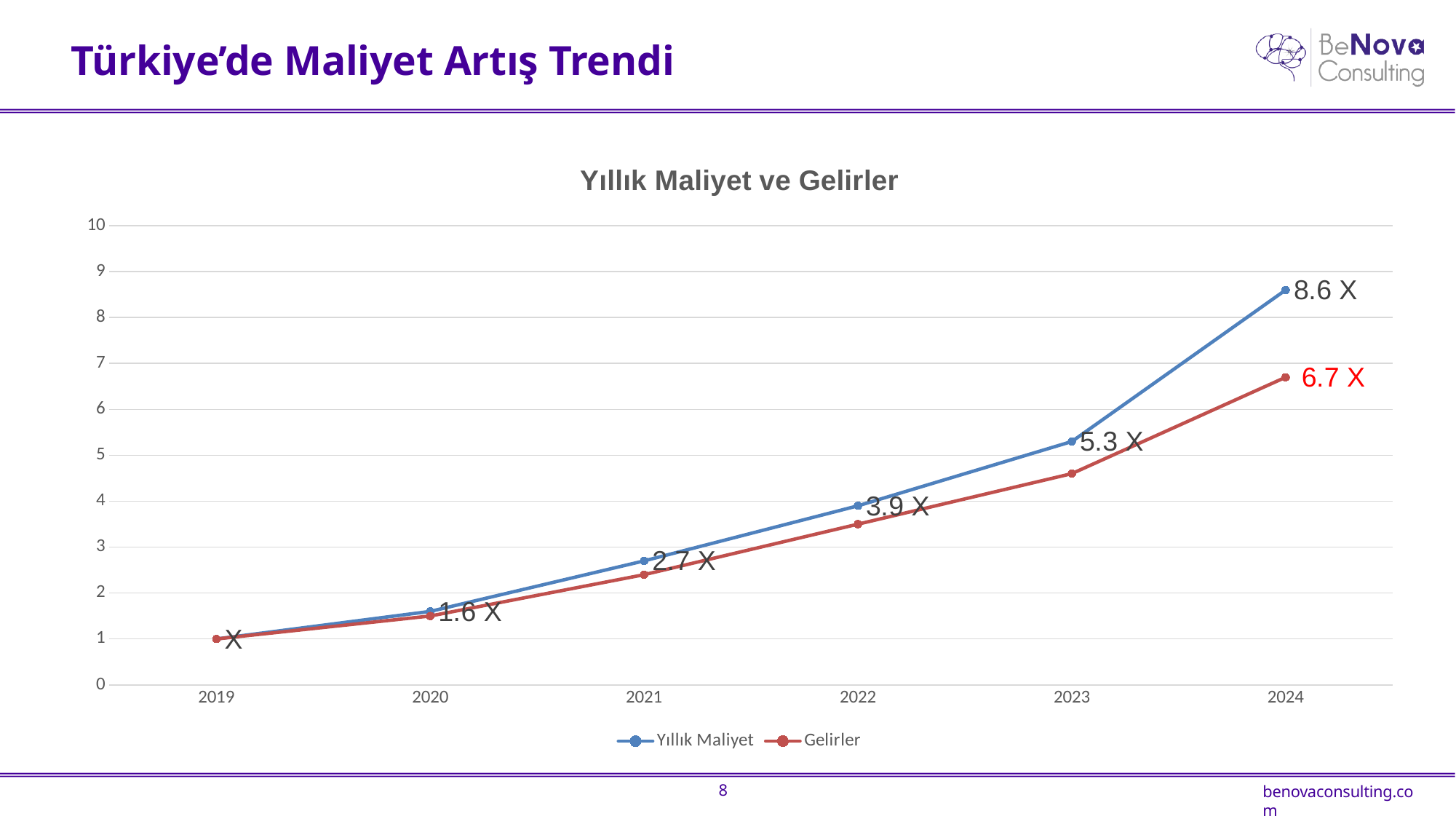
What is the value of Gelirler in 2024? 6.7 X How many years are shown on the x axis? 6 Is the value for Gelirler in 2022 greater or less than 3? greater How many series does the legend list? 2 Is the value for Gelirler in 2023 greater or less than 5? less Do the values of Yıllık Maliyet rise or fall from 2019 to 2024? rise What is the value of Yıllık Maliyet in 2021? 2.7 X In 2024, which series has the larger value, Yıllık Maliyet or Gelirler? Yıllık Maliyet What kind of chart is shown on the slide? line chart What is the value of Yıllık Maliyet in 2023? 5.3 X What is the value of Yıllık Maliyet in 2024? 8.6 X What is the difference between Yıllık Maliyet and Gelirler in 2024? 1.9 X